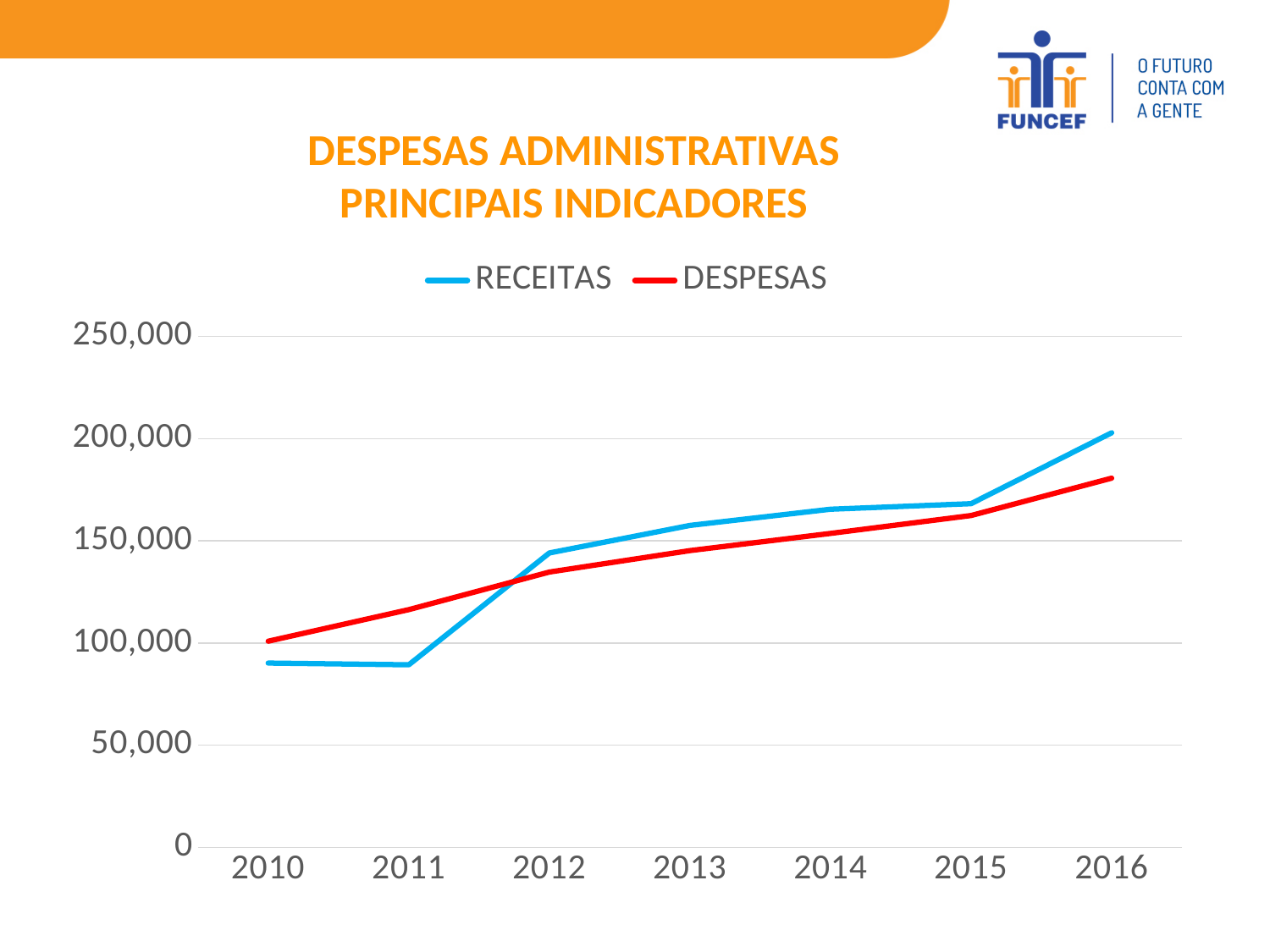
How many years are plotted along the x axis? 7 Is the value for DESPESAS in 2016 greater or less than 200,000? less In 2010, which is larger, RECEITAS or DESPESAS? DESPESAS Does the DESPESAS line rise or fall from 2010 to 2016? rise How many series does the legend list? 2 What kind of chart is shown on the slide? line chart In 2016, which is larger, RECEITAS or DESPESAS? RECEITAS In which year is the RECEITAS line at its highest? 2016 Is the value for DESPESAS in 2015 greater or less than 150,000? greater Which series is drawn in red? DESPESAS Is the value for RECEITAS in 2010 greater or less than 100,000? less In which year is the DESPESAS line at its lowest? 2010